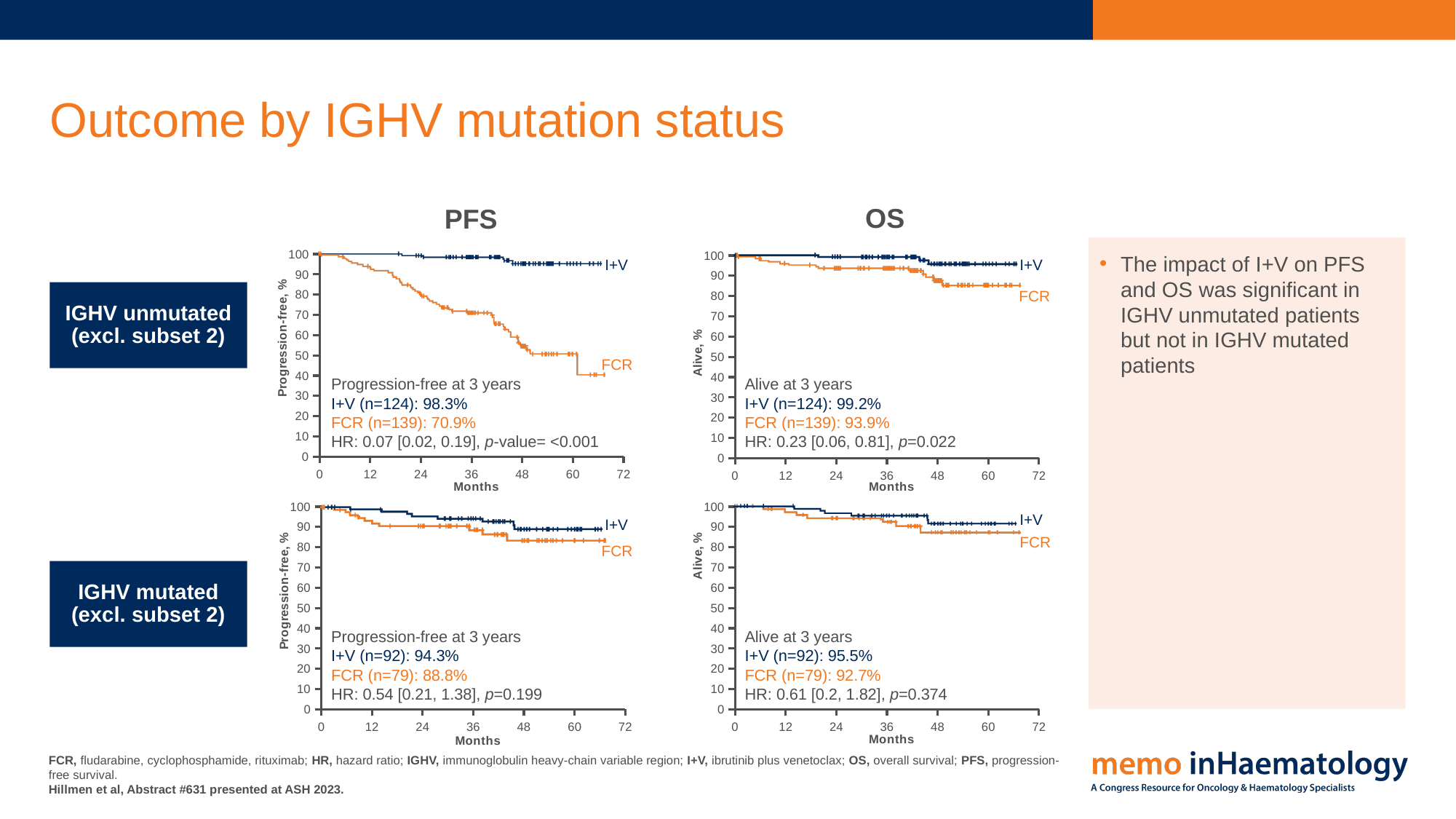
In the PFS chart for IGHV mutated patients, what is the p-value shown? 0.199 In the OS chart for IGHV mutated patients, what percentage of FCR patients were alive at 3 years? 92.7% In the OS chart for IGHV unmutated patients, what percentage of FCR patients were alive at 3 years? 93.9% In the PFS chart for IGHV unmutated patients, what is the difference in 3-year progression-free rate between I+V and FCR? 27.4 percentage points In the PFS chart for IGHV unmutated patients, is the FCR curve at 36 months greater or less than 60? greater In the PFS chart for IGHV mutated patients, what is the progression-free rate at 3 years for I+V? 94.3% In the PFS chart for IGHV unmutated patients, what is the progression-free rate at 3 years for FCR? 70.9% What kind of chart is used in the PFS chart for IGHV unmutated patients? Line chart In the PFS chart for IGHV mutated patients, which treatment has the higher progression-free rate at 3 years? I+V How many treatment curves are plotted in the OS chart for IGHV mutated patients? 2 In the OS chart for IGHV unmutated patients, what is the hazard ratio shown? 0.23 In the PFS chart for IGHV unmutated patients, what is the progression-free rate at 3 years for I+V? 98.3%